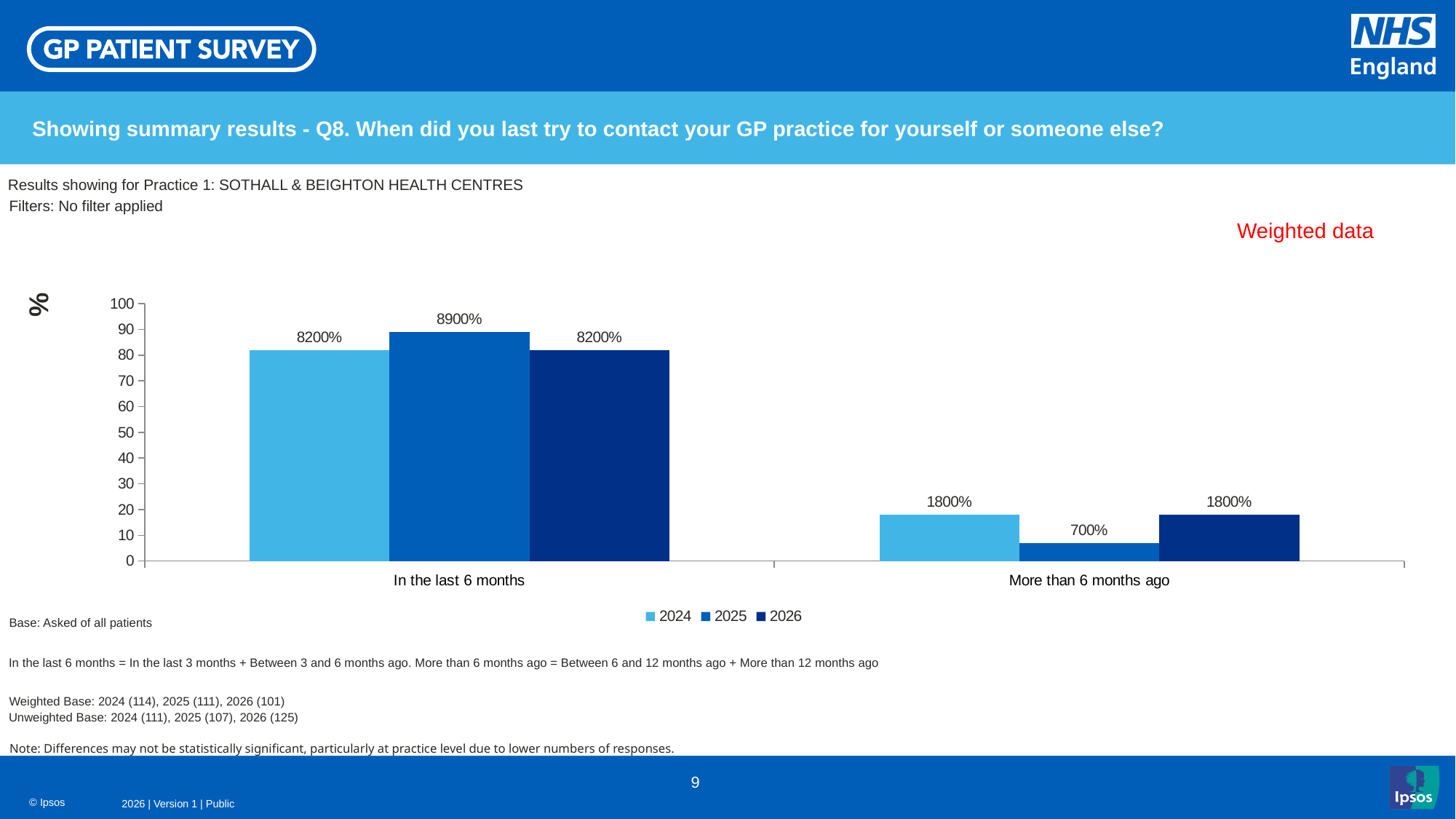
What is the data label for 2025 in the 'In the last 6 months' category? 8900% What type of chart is shown on the slide? Bar chart Is the 2024 bar for 'In the last 6 months' greater or less than 50 on the y axis? greater Which year has the lowest bar in the 'More than 6 months ago' category? 2025 Is the 2025 bar for 'More than 6 months ago' greater or less than 10 on the y axis? less What is the data label for 2026 in the 'In the last 6 months' category? 8200% How many series does the legend list? 3 What is the data label for 2024 in the 'More than 6 months ago' category? 1800% What is the data label for 2025 in the 'More than 6 months ago' category? 700% How many categories are shown on the x axis? 2 Which is larger: the 2025 bar for 'In the last 6 months' or the 2025 bar for 'More than 6 months ago'? In the last 6 months Which year has the highest bar in the 'In the last 6 months' category? 2025